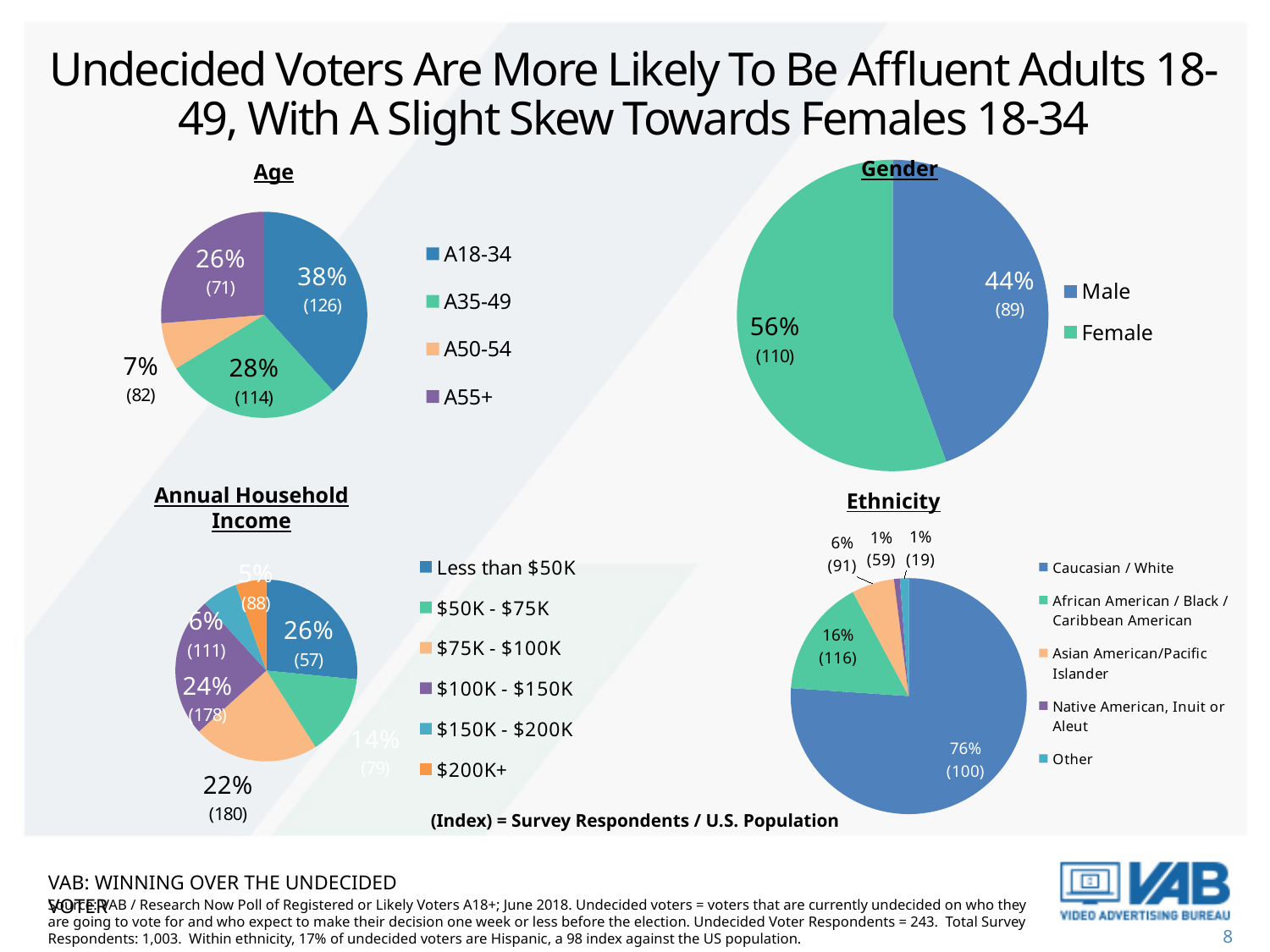
In the Age chart, what share of undecided voters are A18-34? 38% In the Gender chart, what is the difference in percentage points between Female and Male? 12 In the Annual Household Income chart, what share of undecided voters earn $100K - $150K? 24% In the Annual Household Income chart, which income group has the largest share? Less than $50K How many pie charts are shown on the slide? 4 What type of chart is used for the Ethnicity data? Pie chart In the Age chart, what is the index value shown for A55+? 71 In the Ethnicity chart, what is the index value shown for African American / Black / Caribbean American? 116 In the Age chart, which age group has the smallest share? A50-54 In the Ethnicity chart, what share of undecided voters are Caucasian / White? 76% In the Gender chart, what share of undecided voters are Female? 56% How many categories does the legend of the Annual Household Income chart list? 6